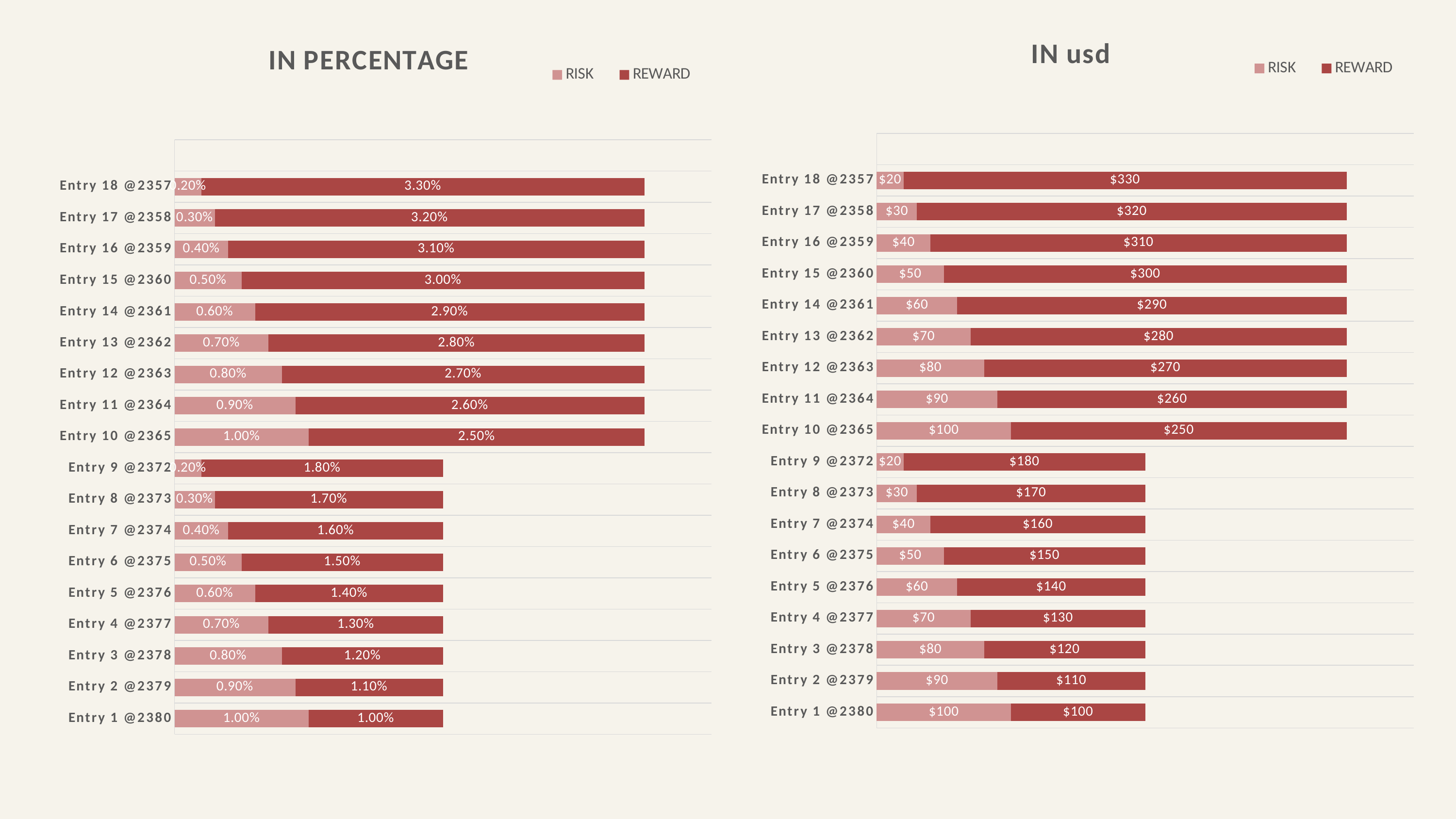
In the "IN usd" chart, which entry has the lowest REWARD value? Entry 1 @2380 How many series does the legend of the "IN PERCENTAGE" chart list? 2 In the "IN usd" chart, what is the REWARD value for Entry 5 @2376? $140 What kind of chart is the "IN usd" chart? Stacked bar chart In the "IN PERCENTAGE" chart, what is the total of the stacked bar for Entry 1 @2380? 2.00% In the "IN usd" chart, what is the total of the stacked bar for Entry 13 @2362? $350 In the "IN PERCENTAGE" chart, which entry has the highest REWARD value? Entry 18 @2357 In the "IN usd" chart, what is the difference between the REWARD values for Entry 18 @2357 and Entry 9 @2372? $150 How many entries are plotted in the "IN usd" chart? 18 In the "IN usd" chart, what is the RISK value for Entry 10 @2365? $100 In the "IN PERCENTAGE" chart, what is the REWARD value for Entry 18 @2357? 3.30% In the "IN PERCENTAGE" chart, which is larger: the REWARD value for Entry 10 @2365 or the REWARD value for Entry 9 @2372? Entry 10 @2365